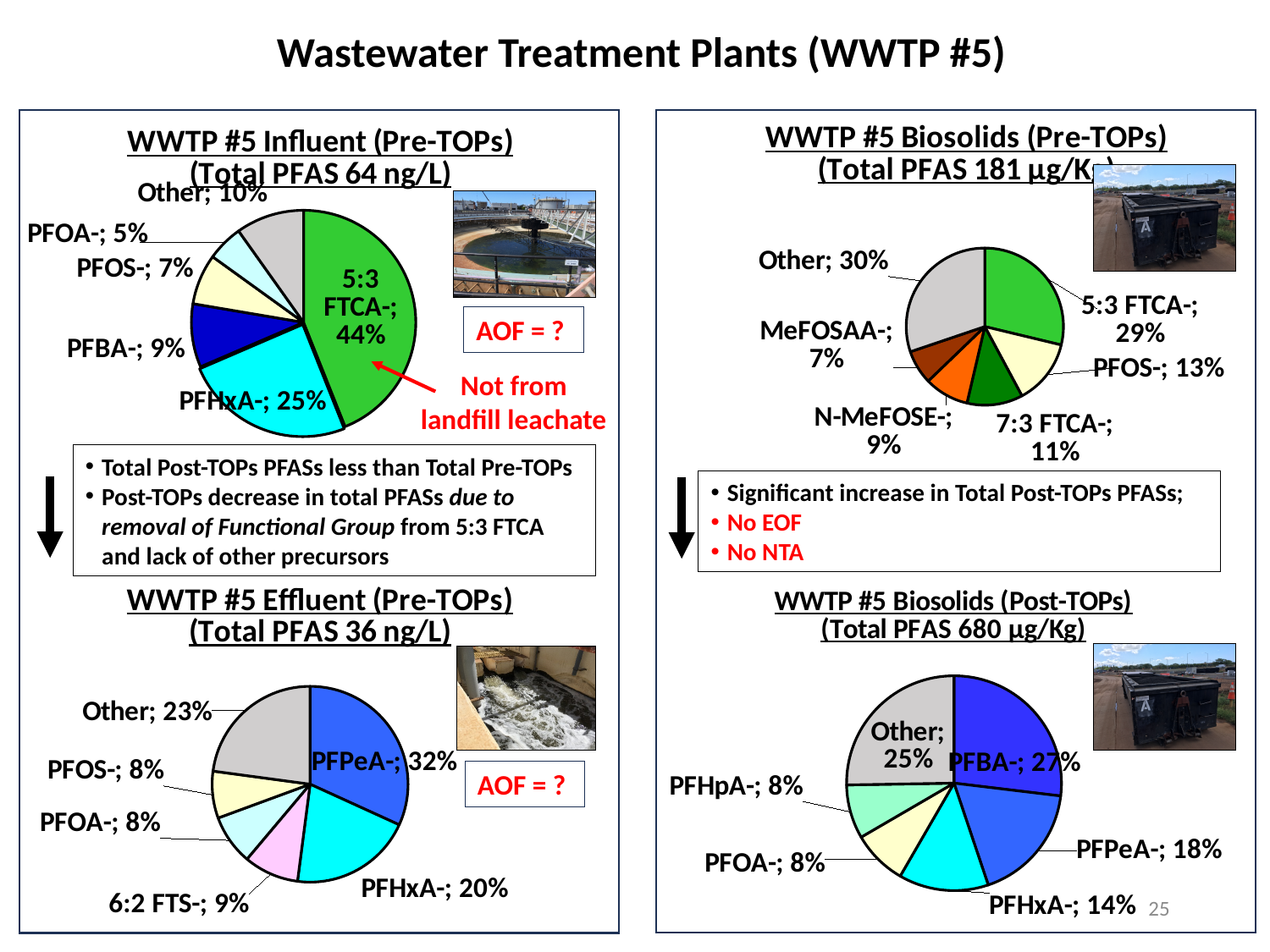
In the WWTP #5 Effluent (Pre-TOPs) chart, what is the difference between the PFPeA- share and the PFHxA- share? 12% In the WWTP #5 Influent (Pre-TOPs) chart, which named compound has the smallest slice? PFOA- In the WWTP #5 Biosolids (Post-TOPs) chart, what share does PFHxA- have? 14% What total PFAS value is given in the title of the WWTP #5 Biosolids (Post-TOPs) chart? 680 µg/Kg In the WWTP #5 Influent (Pre-TOPs) chart, what is the difference between the PFHxA- share and the PFBA- share? 16% What kind of chart is the WWTP #5 Effluent (Pre-TOPs) chart? Pie chart In the WWTP #5 Effluent (Pre-TOPs) chart, what share does PFPeA- have? 32% In the WWTP #5 Biosolids (Pre-TOPs) chart, which is larger, the 7:3 FTCA- slice or the N-MeFOSE- slice? 7:3 FTCA- In the WWTP #5 Influent (Pre-TOPs) chart, what share does 5:3 FTCA- have? 44% In the WWTP #5 Biosolids (Post-TOPs) chart, which named compound has the largest slice? PFBA- How many slices does the WWTP #5 Biosolids (Pre-TOPs) pie chart have? 6 In the WWTP #5 Biosolids (Pre-TOPs) chart, what share does PFOS- have? 13%